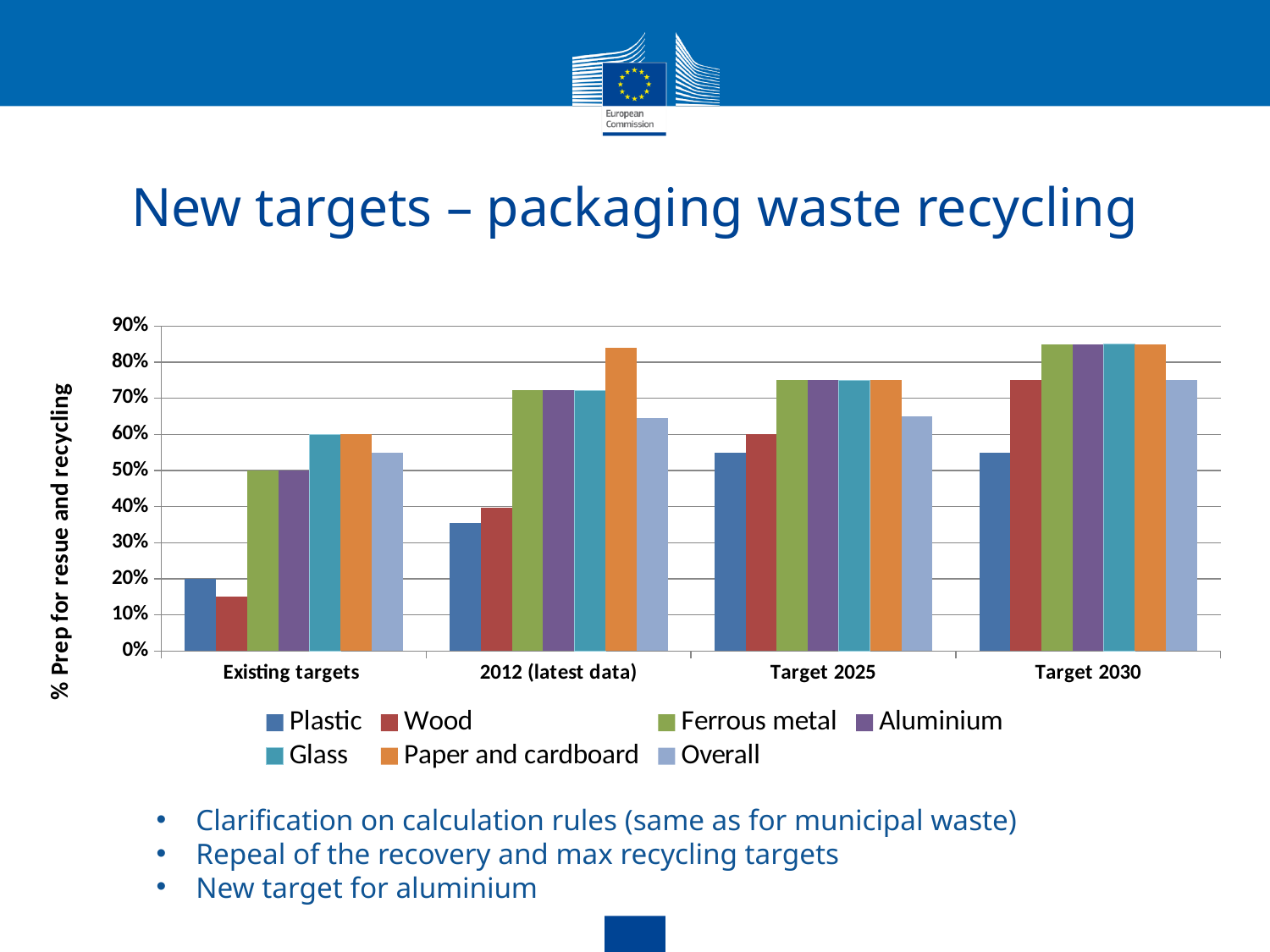
Is the value for Paper and cardboard in 2012 (latest data) greater or less than 80%? greater How many categories are shown along the x axis? 4 How many series does the legend list? 7 What is the label on the vertical axis of the chart? % Prep for resue and recycling Do the values for Wood rise or fall from Existing targets to Target 2030? rise What is the value for Plastic under Existing targets? 20% What type of chart is shown on the slide? bar chart Which series has the highest value in the 2012 (latest data) group? Paper and cardboard What is the value for Wood under Target 2025? 60% Which series has the lowest value in the Existing targets group? Wood What is the value for Glass under Existing targets? 60% In the 2012 (latest data) group, which is larger: Paper and cardboard or Plastic? Paper and cardboard